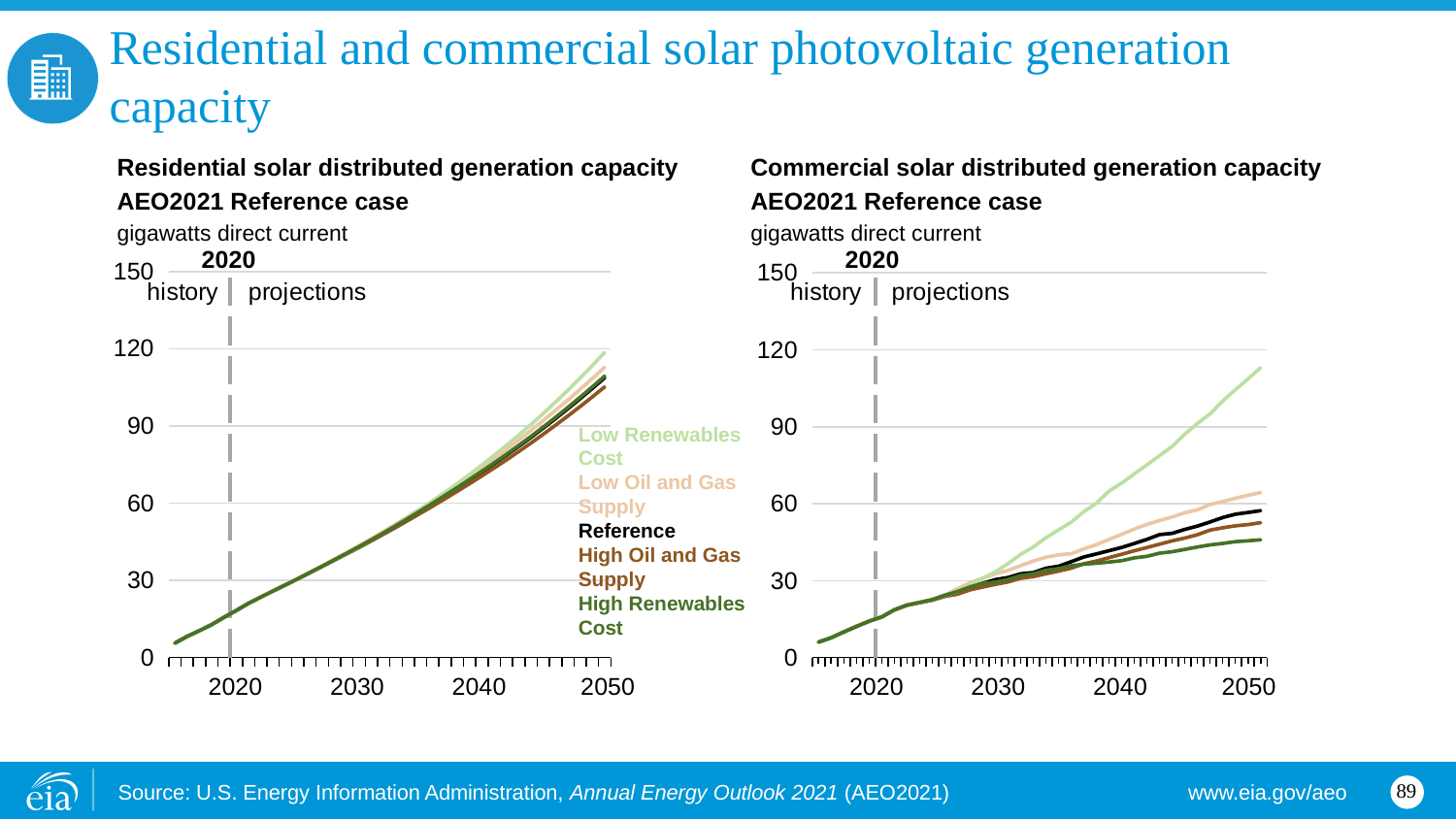
In the Residential solar distributed generation capacity chart, is the value for Reference in 2050 greater or less than 90? greater In the Residential solar distributed generation capacity chart, is the value in 2020 greater or less than 30? less In the Residential solar distributed generation capacity chart, which series is highest in 2050? Low Renewables Cost In the Commercial solar distributed generation capacity chart, is the value for High Renewables Cost in 2050 greater or less than 60? less What kind of chart is the Residential solar distributed generation capacity chart? line chart In the Commercial solar distributed generation capacity chart, which series is highest in 2050? Low Renewables Cost In the Commercial solar distributed generation capacity chart, which is larger in 2050: Low Renewables Cost or Reference? Low Renewables Cost How many series are listed in the legend shared by the two charts? 5 What year does the dashed vertical line separating history from projections mark? 2020 What unit is used on the y axis of both charts? gigawatts direct current In the Residential solar distributed generation capacity chart, do the values rise or fall from 2020 to 2050? rise